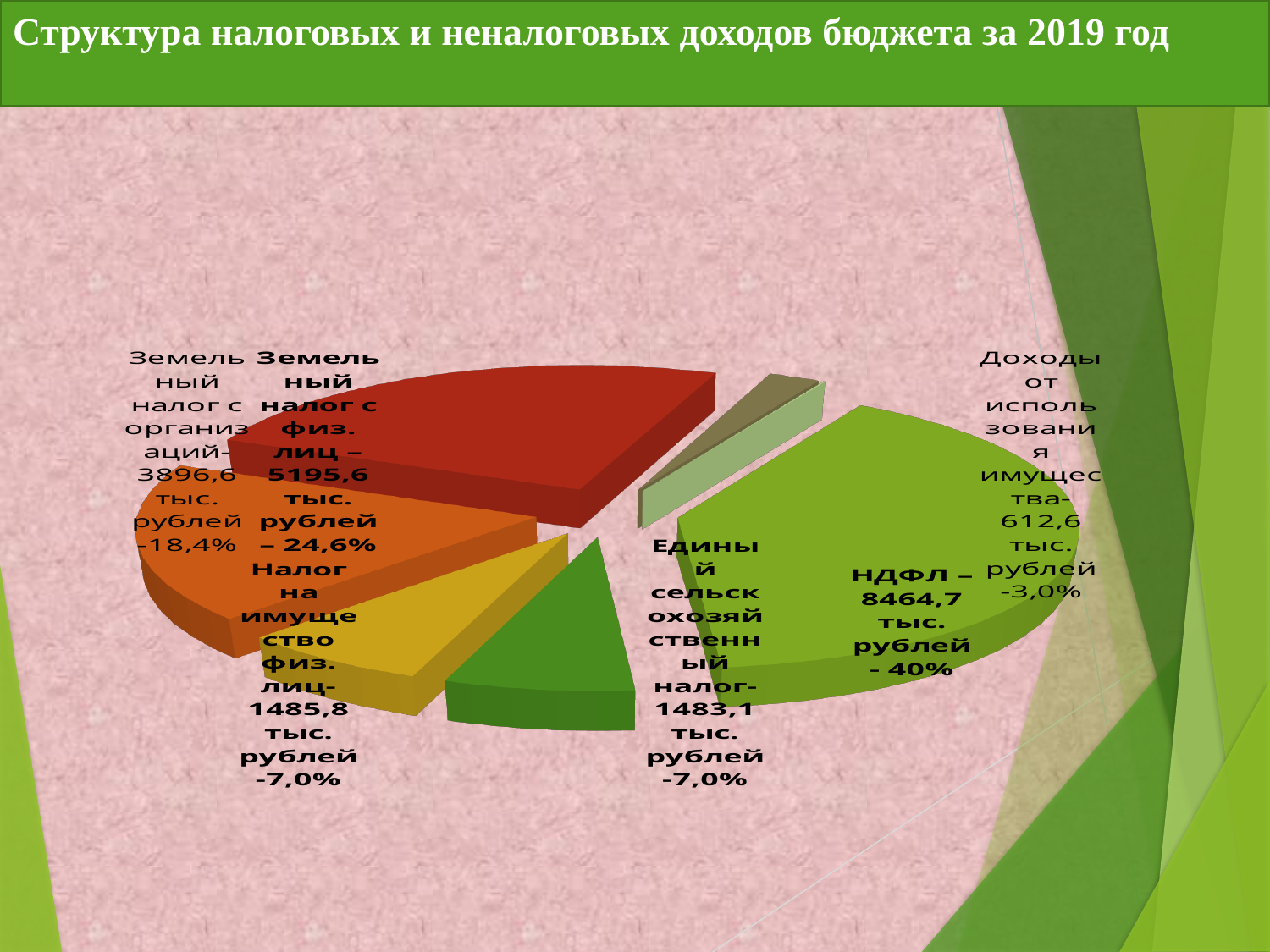
What share of the pie does Земельный налог с организаций represent? 18,4% What share of the pie does НДФЛ represent? 40% Which category has the smallest share of the pie? Доходы от использования имущества What kind of chart is shown on the slide? Pie chart What is the difference in share between НДФЛ and Земельный налог с физ. лиц? 15,4% What is the title of the chart on the slide? Структура налоговых и неналоговых доходов бюджета за 2019 год Which category has the largest share of the pie? НДФЛ What is the value for Доходы от использования имущества? 612,6 тыс. рублей How many slices does the pie chart have? 6 Which is larger: Земельный налог с физ. лиц or Земельный налог с организаций? Земельный налог с физ. лиц What is the value for НДФЛ? 8464,7 тыс. рублей What is the value for Земельный налог с физ. лиц? 5195,6 тыс. рублей